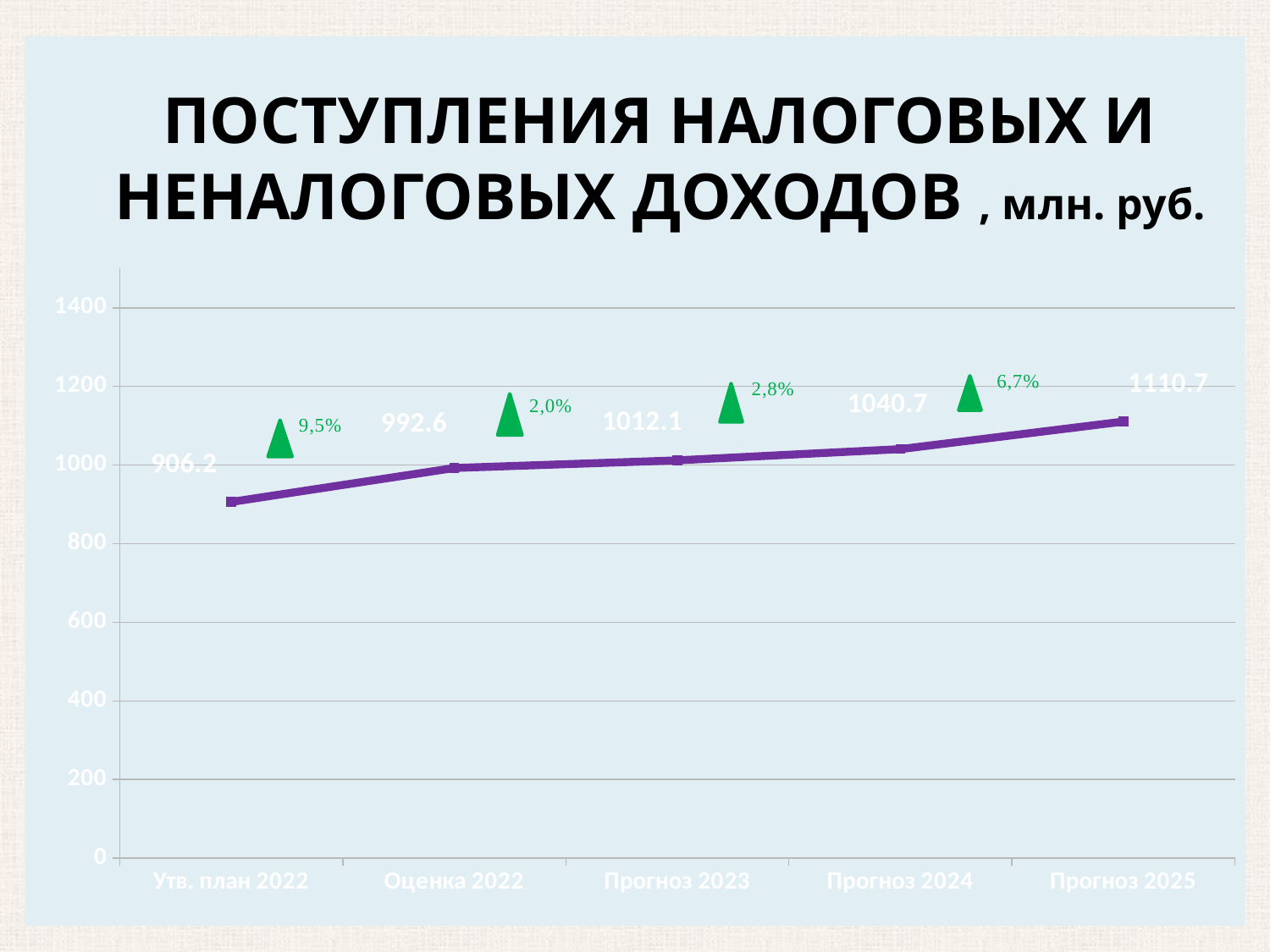
Which category has the highest value? Прогноз 2025 What is the value for Прогноз 2024? 1040.7 What is the value for Утв. план 2022? 906.2 What is the value for Оценка 2022? 992.6 What type of chart is shown on the slide? line chart Do the values rise or fall from Утв. план 2022 to Прогноз 2025? rise Which is larger, the value for Прогноз 2023 or the value for Оценка 2022? Прогноз 2023 How many data points are plotted on the line? 5 Which category has the lowest value? Утв. план 2022 What is the difference between the values for Прогноз 2025 and Прогноз 2024? 70.0 What is the value for Прогноз 2025? 1110.7 What percentage growth is shown by the green arrow between Прогноз 2024 and Прогноз 2025? 6,7%